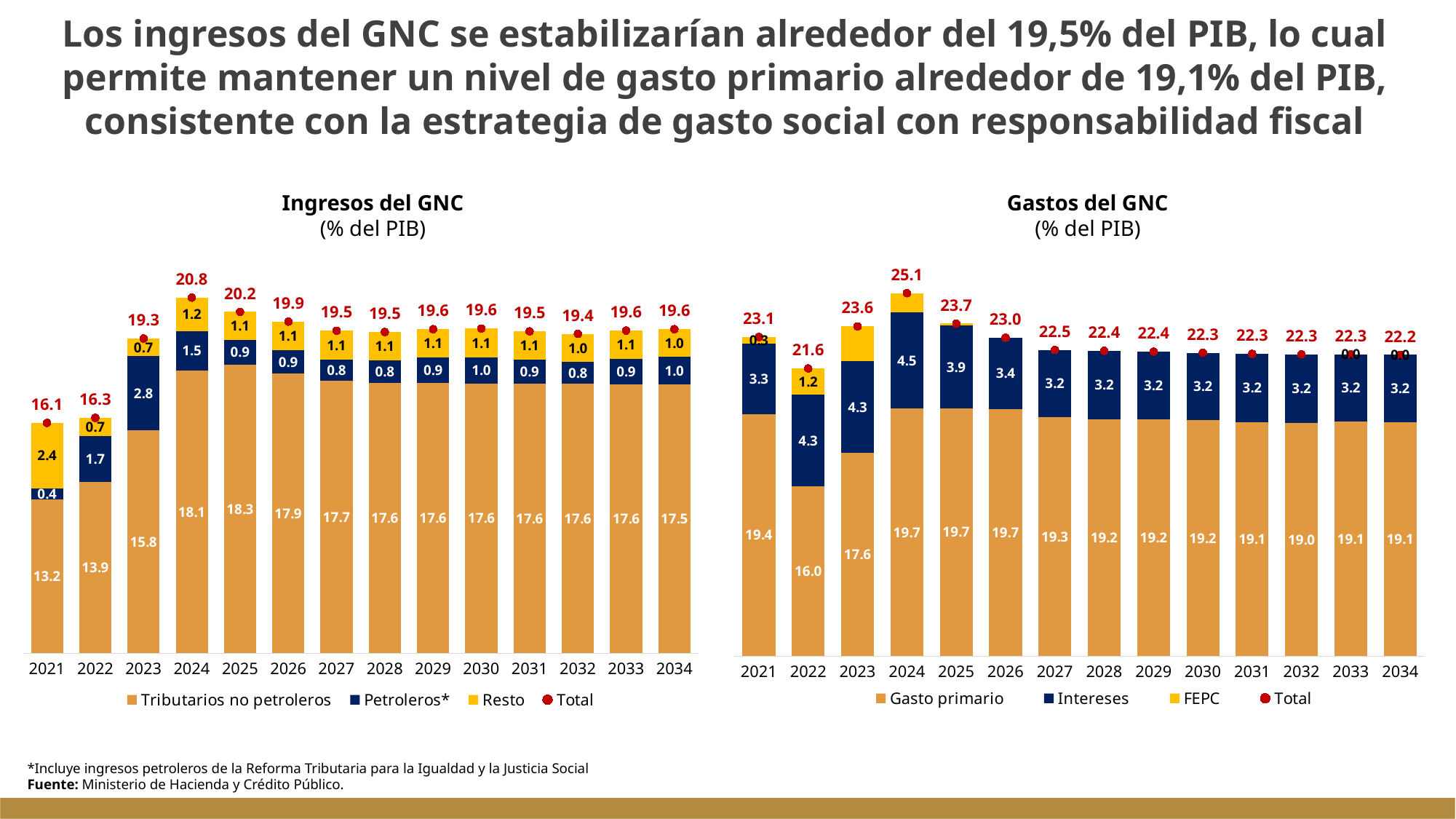
How many years are shown on the x axis of the 'Gastos del GNC' chart? 14 In the 'Gastos del GNC' chart, what is the value of Intereses for 2024? 4.5 In the 'Ingresos del GNC' chart, what is the value of Tributarios no petroleros for 2021? 13.2 How many entries does the legend of the 'Ingresos del GNC' chart list? 4 In the 'Ingresos del GNC' chart, which year has the lowest Total? 2021 In the 'Gastos del GNC' chart, what is the value of Gasto primario for 2022? 16.0 In the 'Ingresos del GNC' chart, which year has the highest Total? 2024 In the 'Ingresos del GNC' chart, what is the difference between the Total for 2024 and the Total for 2021? 4.7 In the 'Ingresos del GNC' chart, what is the value of Petroleros* for 2023? 2.8 In the 'Ingresos del GNC' chart, what is the Total for 2024? 20.8 In the 'Gastos del GNC' chart, is the Total for 2022 larger or smaller than the Total for 2023? smaller In the 'Gastos del GNC' chart, which year has the highest Total? 2024